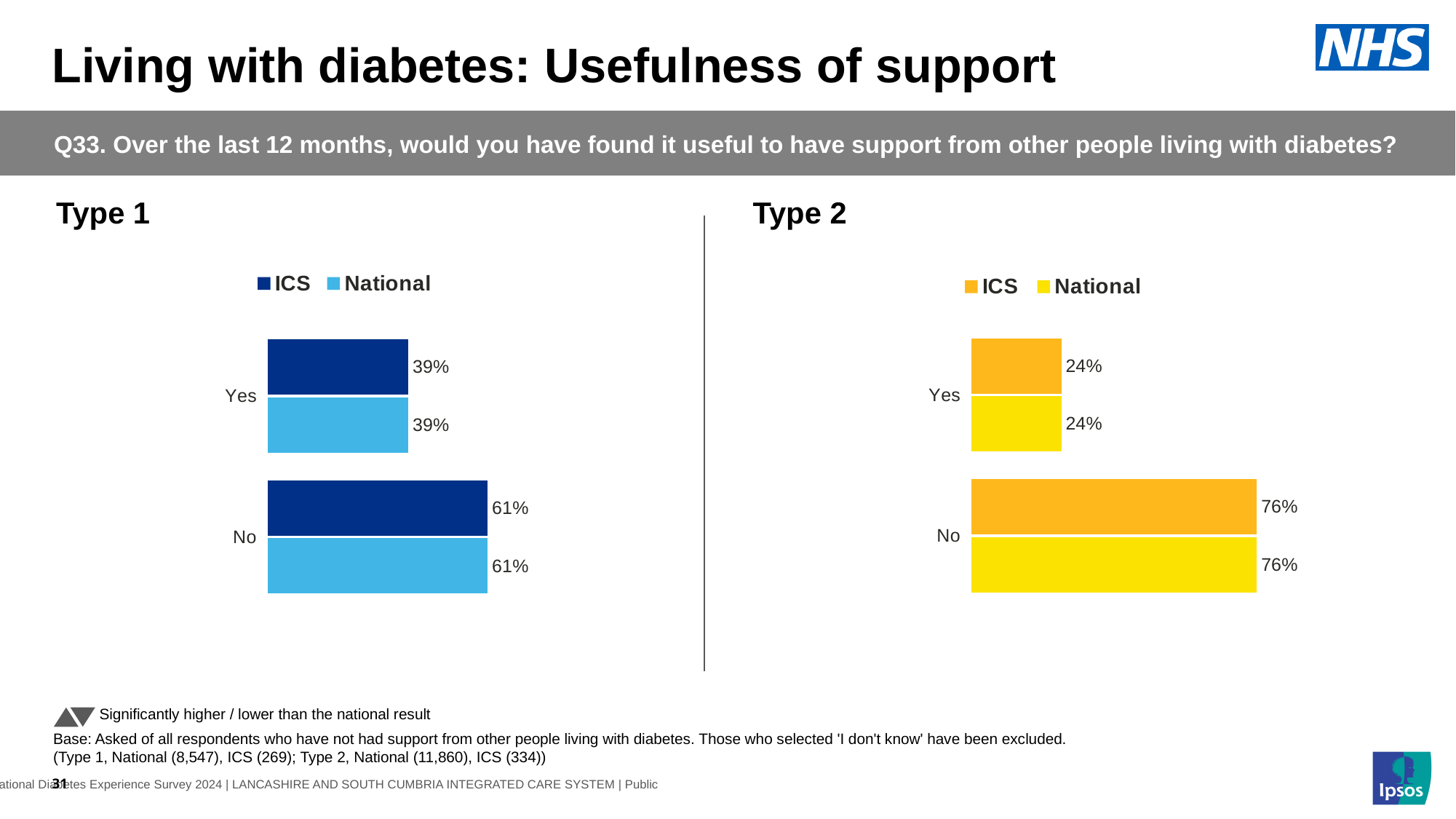
What kind of chart is the Type 1 chart? Bar chart In the Type 1 chart, what is the ICS value for Yes? 39% In the Type 2 chart, which category has the highest ICS value? No How many categories are shown in the Type 1 chart? 2 In the Type 2 chart, what is the ICS value for No? 76% In the Type 1 chart, which category has the lowest National value? Yes In the Type 2 chart, what is the difference between the National values for No and Yes? 52 percentage points In the Type 2 chart, what is the National value for Yes? 24% Is the ICS value for No larger in the Type 1 chart or the Type 2 chart? Type 2 In the Type 1 chart, what is the National value for No? 61% In the Type 1 chart, what is the difference between the ICS values for No and Yes? 22 percentage points How many series does the legend of the Type 2 chart list? 2